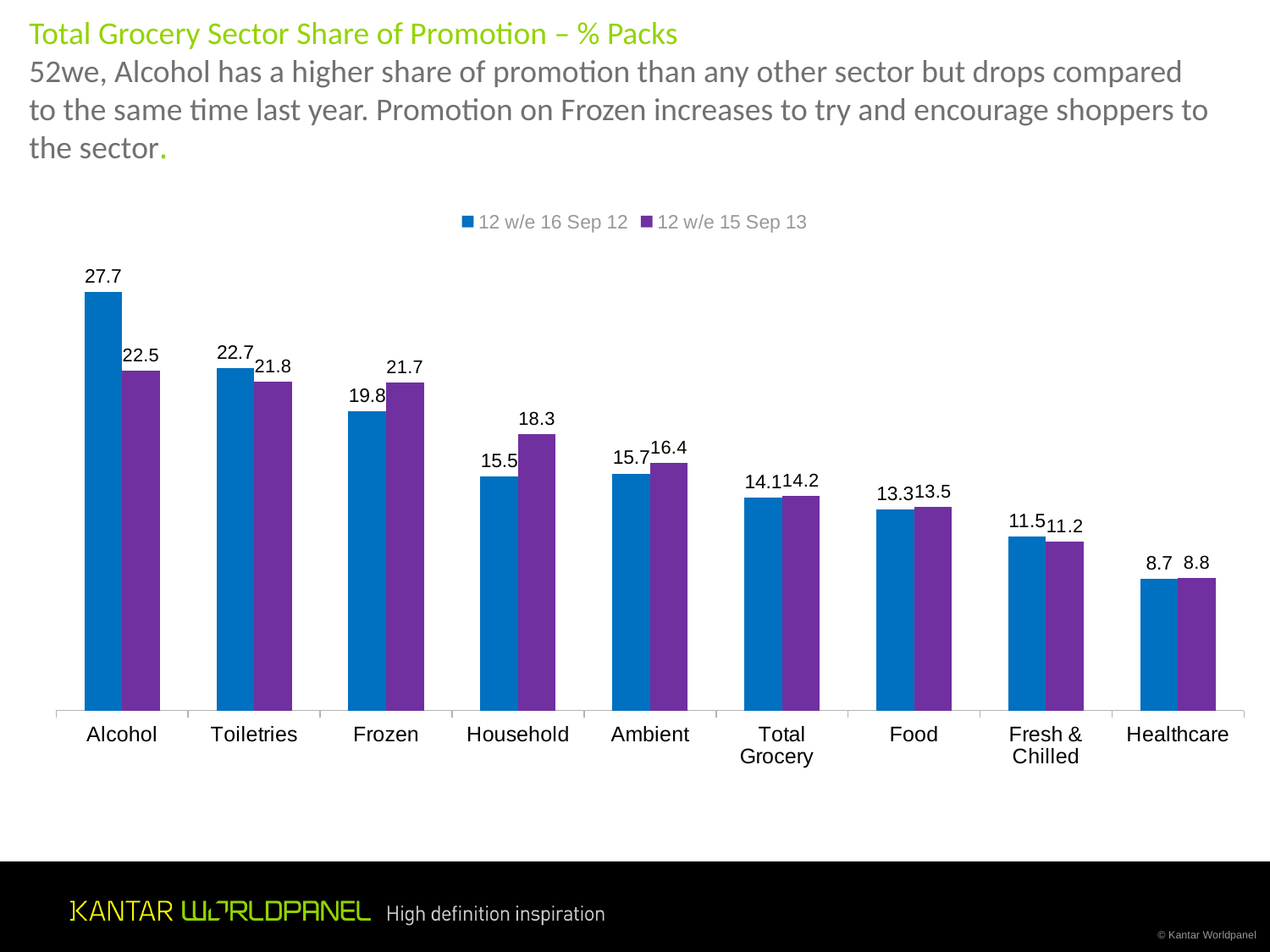
What is the value for Frozen in the 12 w/e 15 Sep 13 series? 21.7 What is the difference between the 12 w/e 15 Sep 13 and 12 w/e 16 Sep 12 values for Household? 2.8 What is the difference between the 12 w/e 16 Sep 12 and 12 w/e 15 Sep 13 values for Alcohol? 5.2 Which category has the highest value in the 12 w/e 16 Sep 12 series? Alcohol What kind of chart is shown on the slide? Bar chart What is the value for Household in the 12 w/e 15 Sep 13 series? 18.3 For Frozen, which series has the larger value: 12 w/e 16 Sep 12 or 12 w/e 15 Sep 13? 12 w/e 15 Sep 13 How many series does the legend list? 2 What is the value for Alcohol in the 12 w/e 16 Sep 12 series? 27.7 Which category has the lowest value in the 12 w/e 15 Sep 13 series? Healthcare How many categories are shown on the x axis? 9 What colour are the bars for the 12 w/e 15 Sep 13 series? Purple